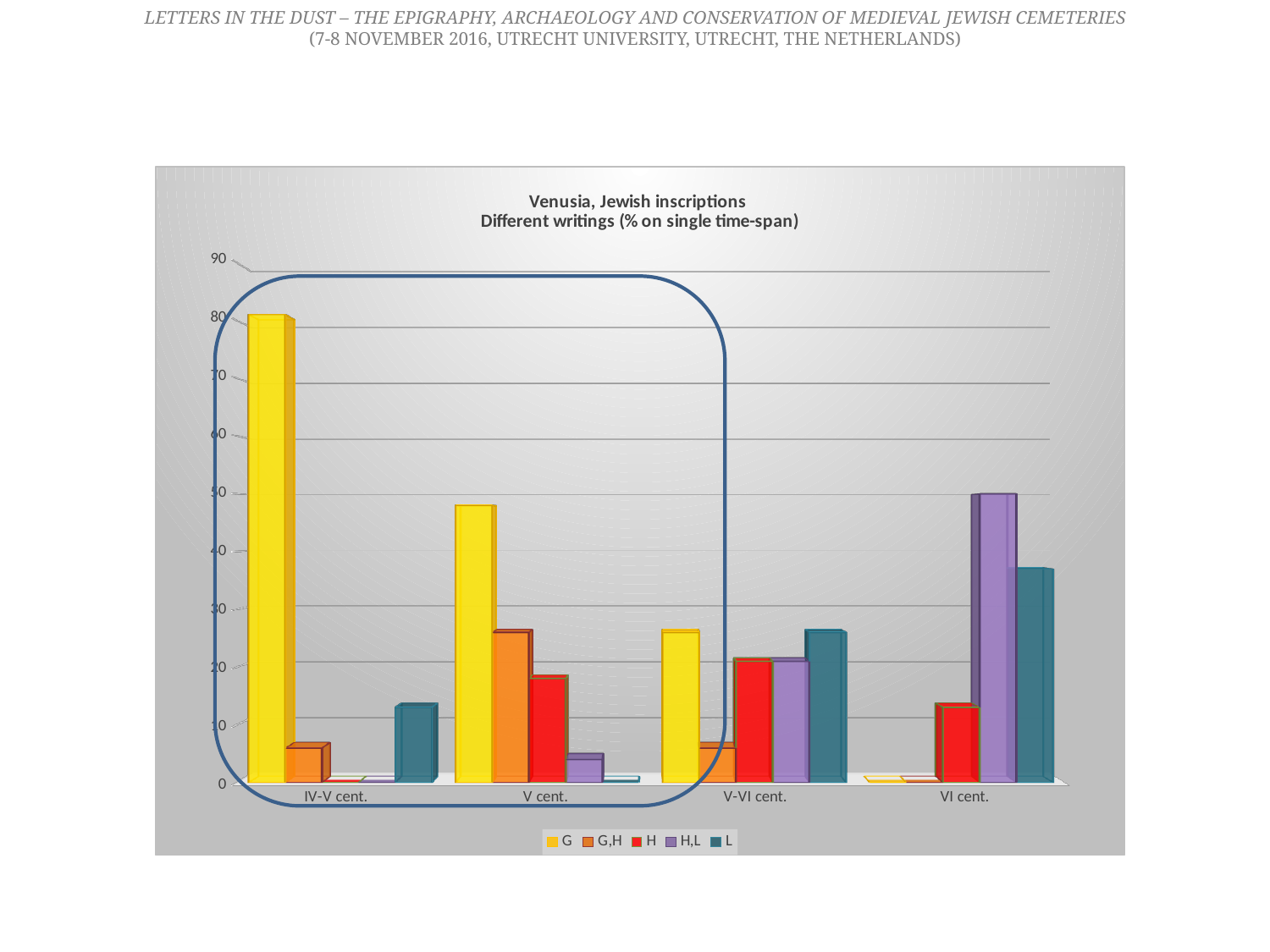
Which is larger for V cent., the value for H or the value for H,L? H What is the title of the chart? Venusia, Jewish inscriptions Different writings (% on single time-span) How many series does the legend list? 5 What kind of chart is shown on the slide? bar chart Do the values for G rise or fall from IV-V cent. to VI cent.? fall How many time-span categories are shown on the x axis? 4 Is the value for L in IV-V cent. greater or less than 20? less Is the value for G in IV-V cent. greater or less than 70? greater Which series has the highest value for IV-V cent.? G Is the value for H,L in VI cent. greater or less than 40? greater Which series has the highest value for VI cent.? H,L In which time-span category is the value for G the highest? IV-V cent.